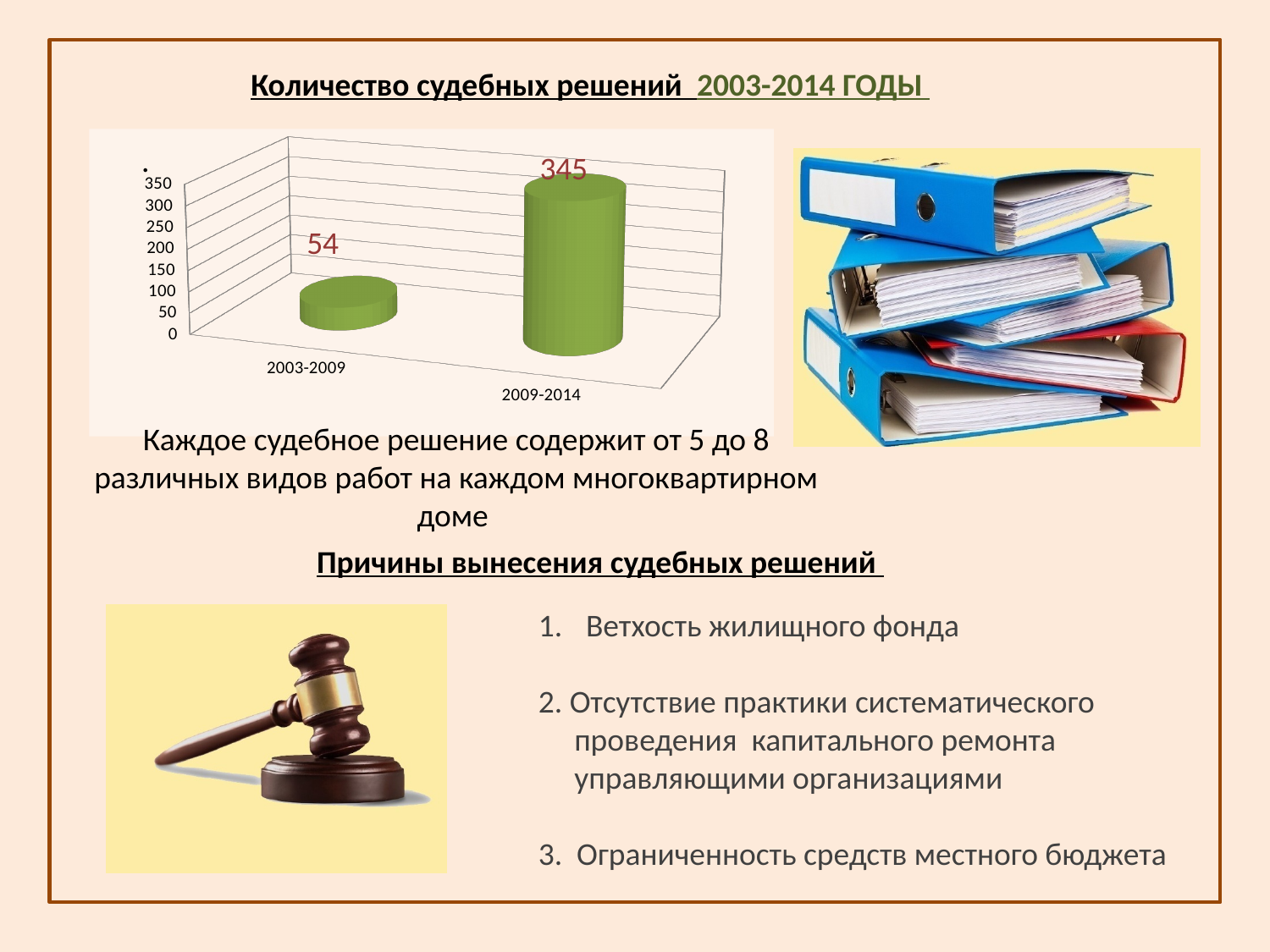
What is the value for 2009-2014? 345 How many categories are shown on the chart? 2 What is the value for 2003-2009? 54 What is the maximum value shown on the chart's vertical axis? 350 Is the value for 2009-2014 greater or less than 300? greater What kind of chart is shown on the slide? bar chart Do the values rise or fall from 2003-2009 to 2009-2014? rise What is the difference between the values for 2009-2014 and 2003-2009? 291 Which period has the highest value? 2009-2014 Which is larger, the value for 2003-2009 or the value for 2009-2014? 2009-2014 Which period has the lowest value? 2003-2009 Is the value for 2003-2009 greater or less than 100? less